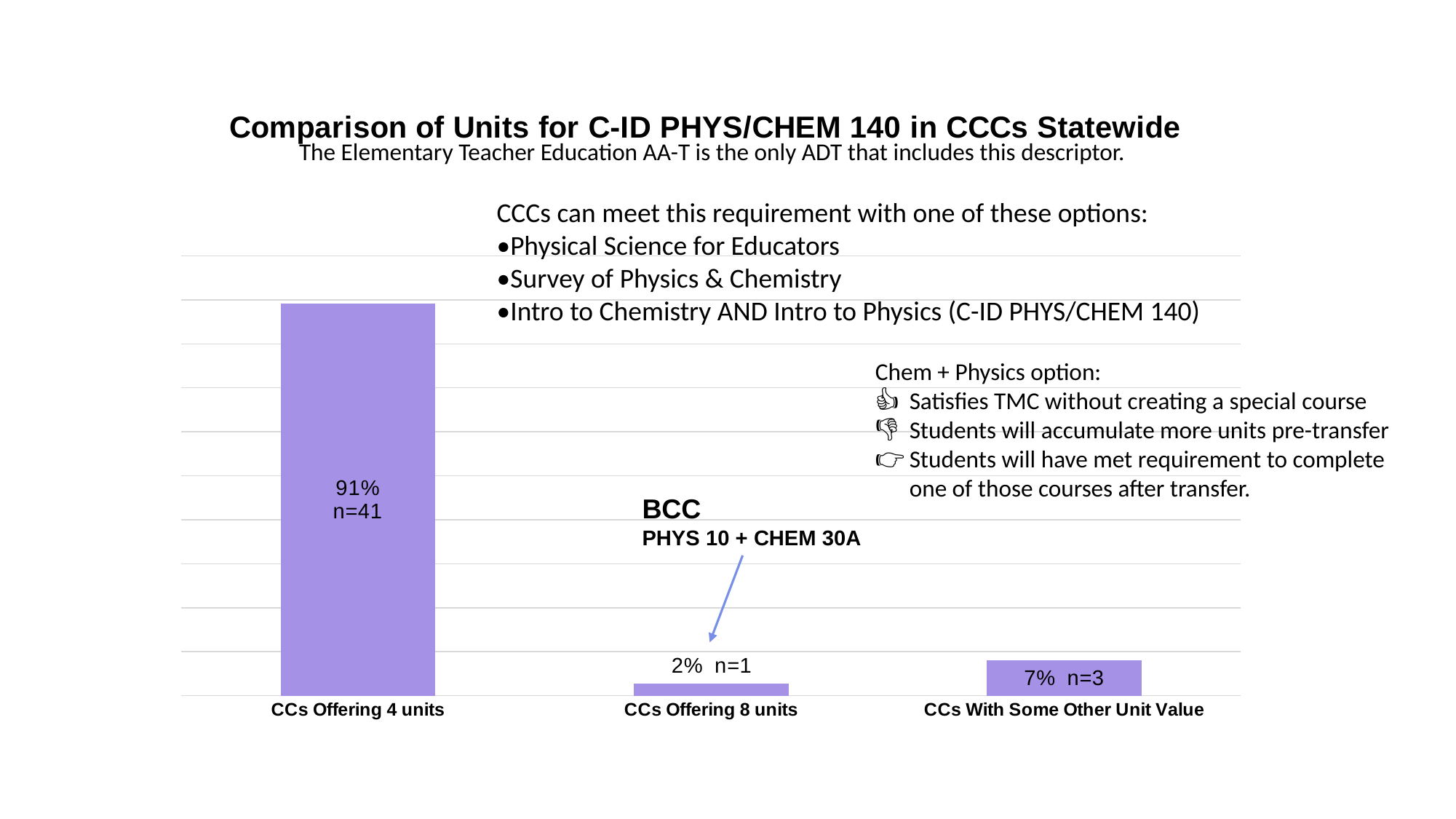
Which college is labelled with the arrow pointing to the CCs Offering 8 units bar? BCC What percentage is shown for CCs Offering 8 units? 2% What percentage is shown for CCs Offering 4 units? 91% Which category has the lowest value? CCs Offering 8 units Which is larger, the value for CCs Offering 8 units or CCs With Some Other Unit Value? CCs With Some Other Unit Value What is the title of the chart? Comparison of Units for C-ID PHYS/CHEM 140 in CCCs Statewide How many categories are plotted in the chart? 3 What is the n value shown for CCs With Some Other Unit Value? n=3 What is the n value shown for CCs Offering 4 units? n=41 What is the difference in percentage between CCs Offering 4 units and CCs With Some Other Unit Value? 84% Which category has the highest value? CCs Offering 4 units What kind of chart is shown on the slide? bar chart